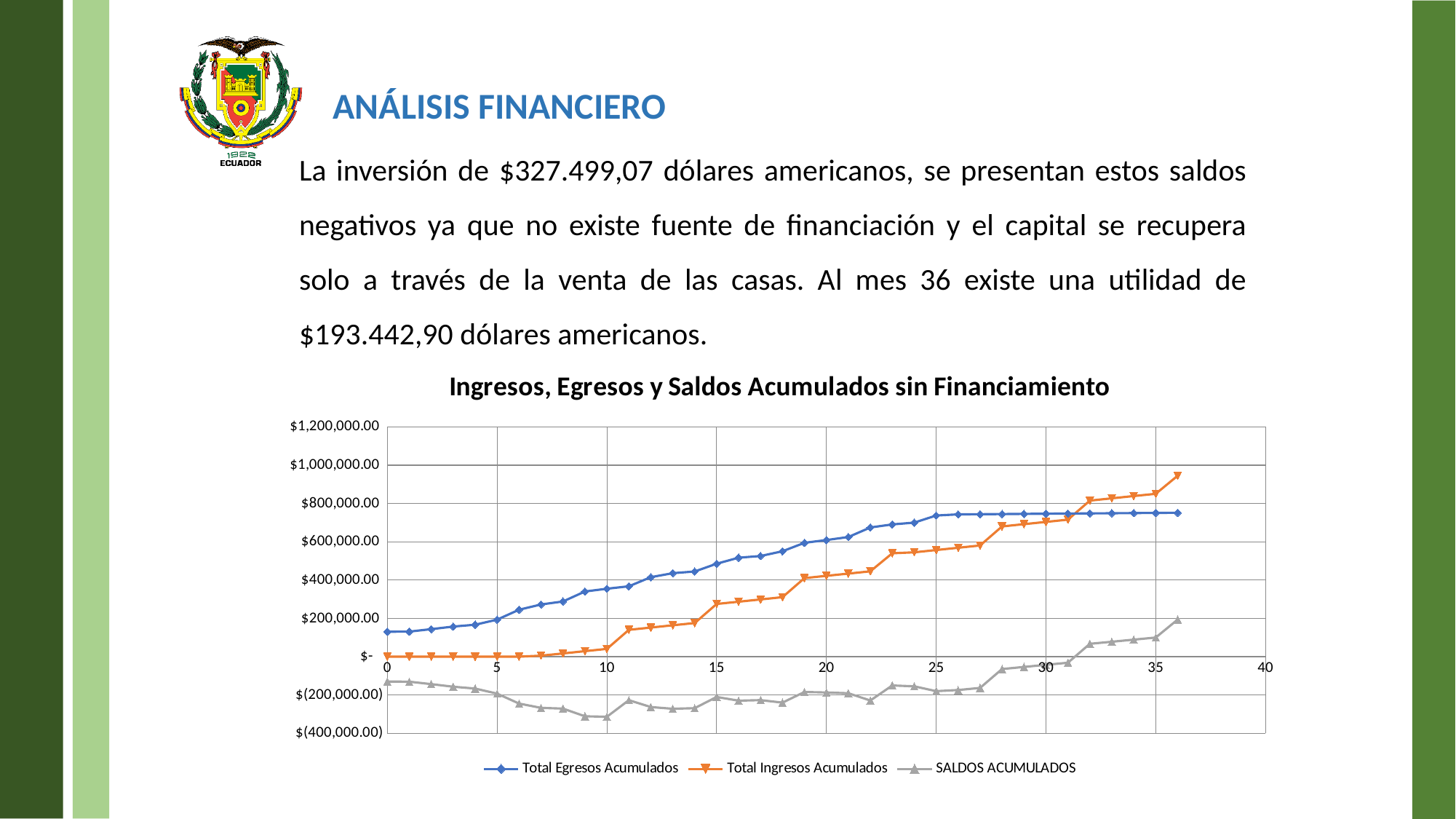
Is the value of SALDOS ACUMULADOS at month 10 greater or less than $(200,000.00)? less Which series in the legend is drawn with grey triangle markers? SALDOS ACUMULADOS At month 36, which series is larger: Total Ingresos Acumulados or Total Egresos Acumulados? Total Ingresos Acumulados Does the Total Egresos Acumulados series rise or fall as the months increase along the x axis? rise What kind of chart is shown on the slide? line chart Is the value of Total Ingresos Acumulados at month 5 greater or less than $200,000.00? less At month 20, which series is larger: Total Egresos Acumulados or Total Ingresos Acumulados? Total Egresos Acumulados Is the value of Total Ingresos Acumulados at month 36 greater or less than $800,000.00? greater Does the Total Ingresos Acumulados series rise or fall from month 0 to month 36? rise What is the title of the chart? Ingresos, Egresos y Saldos Acumulados sin Financiamiento How many series does the legend of the chart list? 3